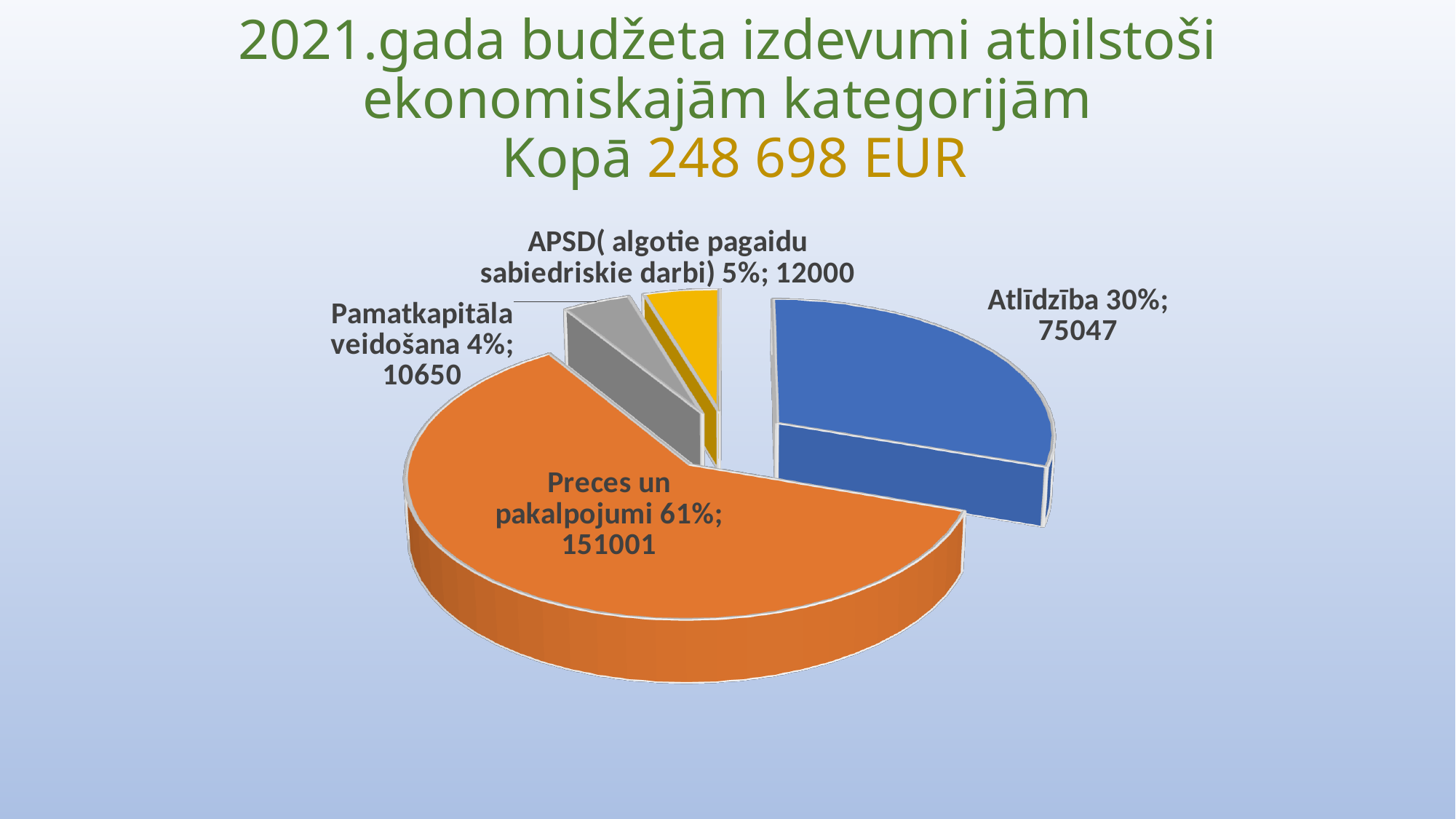
Which category has the largest slice of the pie? Preces un pakalpojumi What share of the pie does Preces un pakalpojumi represent? 61% What share of the pie does Atlīdzība represent? 30% Which is larger, the value for APSD (algotie pagaidu sabiedriskie darbi) or the value for Pamatkapitāla veidošana? APSD (algotie pagaidu sabiedriskie darbi) What is the value for Preces un pakalpojumi? 151001 What is the value for Pamatkapitāla veidošana? 10650 What is the value for APSD (algotie pagaidu sabiedriskie darbi)? 12000 What is the value for Atlīdzība? 75047 How many categories are shown in the pie chart? 4 What kind of chart is shown on the slide? Pie chart What is the difference between the values for Preces un pakalpojumi and Atlīdzība? 75954 Which category has the smallest slice of the pie? Pamatkapitāla veidošana